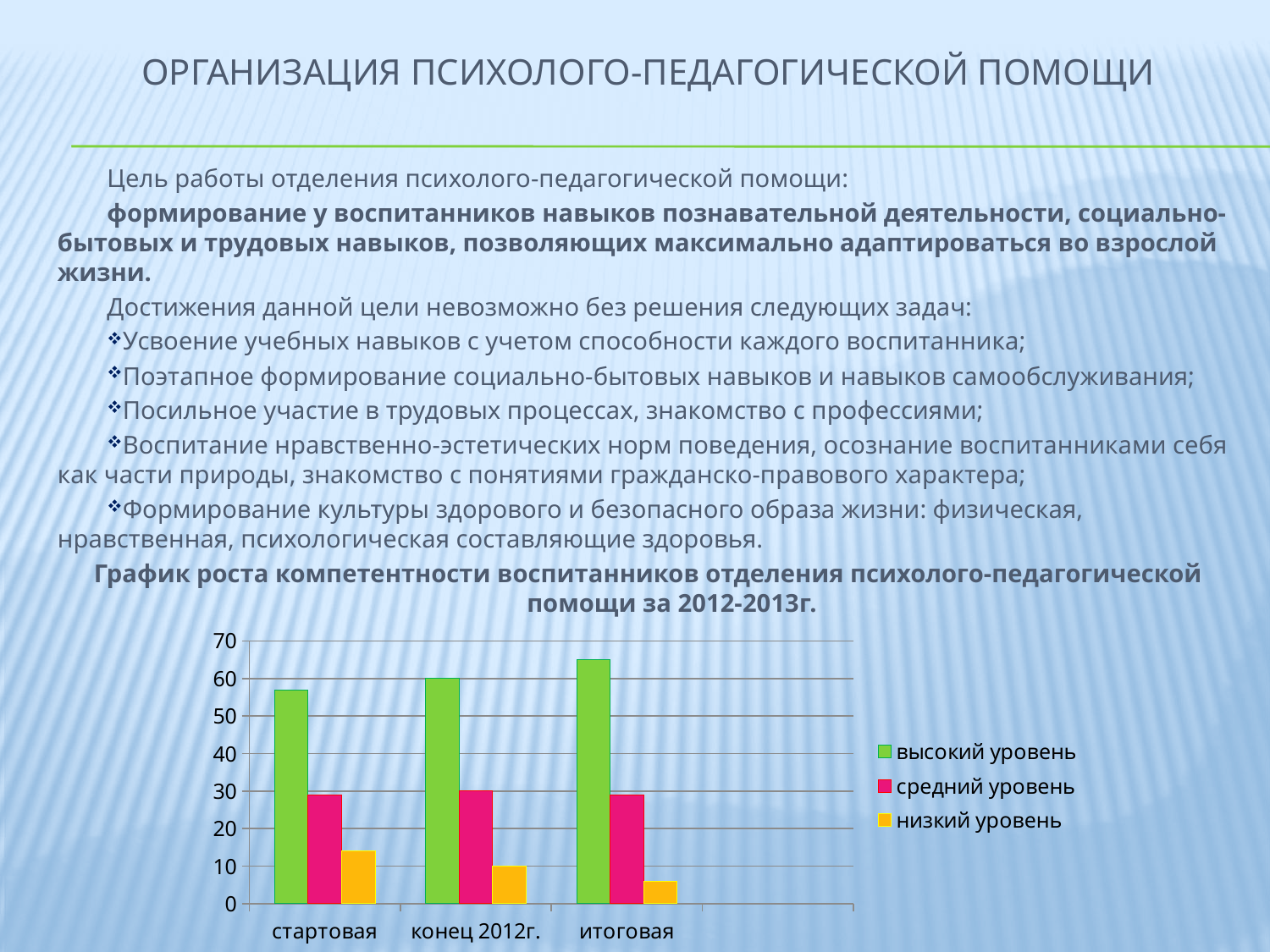
Do the values for низкий уровень rise or fall from стартовая to итоговая? fall What kind of chart is shown on the slide? bar chart Is the value for низкий уровень in итоговая greater or less than 10? less Is the value for средний уровень in стартовая greater or less than 40? less How many series does the chart legend list? 3 What is the value for высокий уровень in конец 2012г.? 60 Which category has the highest value for высокий уровень? итоговая Is the value for высокий уровень in стартовая greater or less than 50? greater In the стартовая category, which is larger: высокий уровень or средний уровень? высокий уровень How many categories are shown on the x axis of the chart? 3 Do the values for высокий уровень rise or fall from стартовая to итоговая? rise Which category has the lowest value for низкий уровень? итоговая